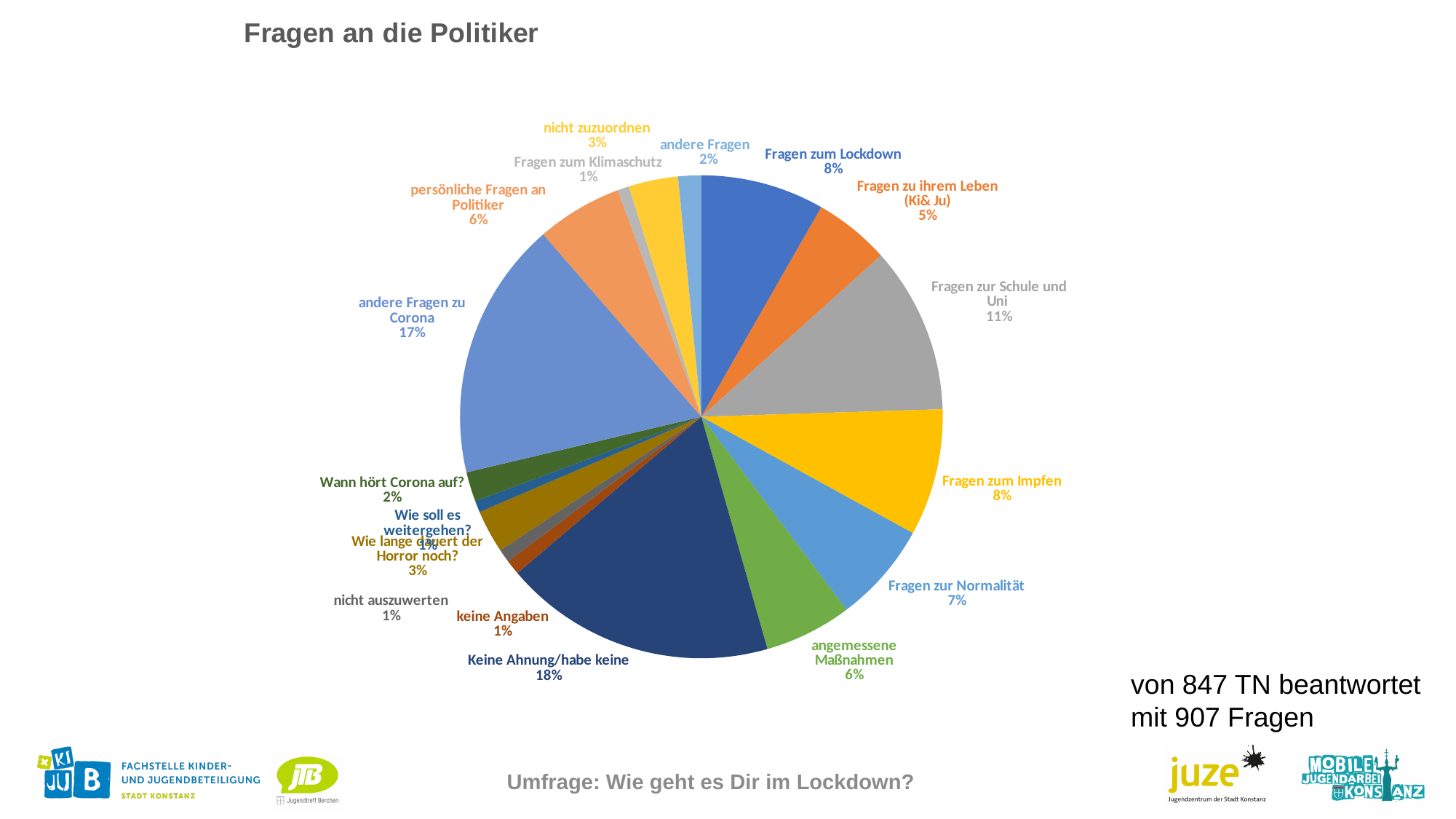
How many slices does the pie chart have? 17 What is the difference in percentage points between 'Keine Ahnung/habe keine' and 'andere Fragen zu Corona'? 1 percentage point What is the title of the chart? Fragen an die Politiker Which category has the largest share of the pie? Keine Ahnung/habe keine Which is larger, 'Fragen zur Normalität' or 'angemessene Maßnahmen'? Fragen zur Normalität What percentage is shown for 'andere Fragen zu Corona'? 17% What type of chart is shown on the slide? pie chart What share of the pie is 'Fragen zur Schule und Uni'? 11% What percentage is shown for 'Fragen zum Impfen'? 8% What percentage is shown for 'Fragen zu ihrem Leben (Ki& Ju)'? 5% What percentage is shown for 'persönliche Fragen an Politiker'? 6% What is the combined share of 'Fragen zum Lockdown' and 'Fragen zum Impfen'? 16%